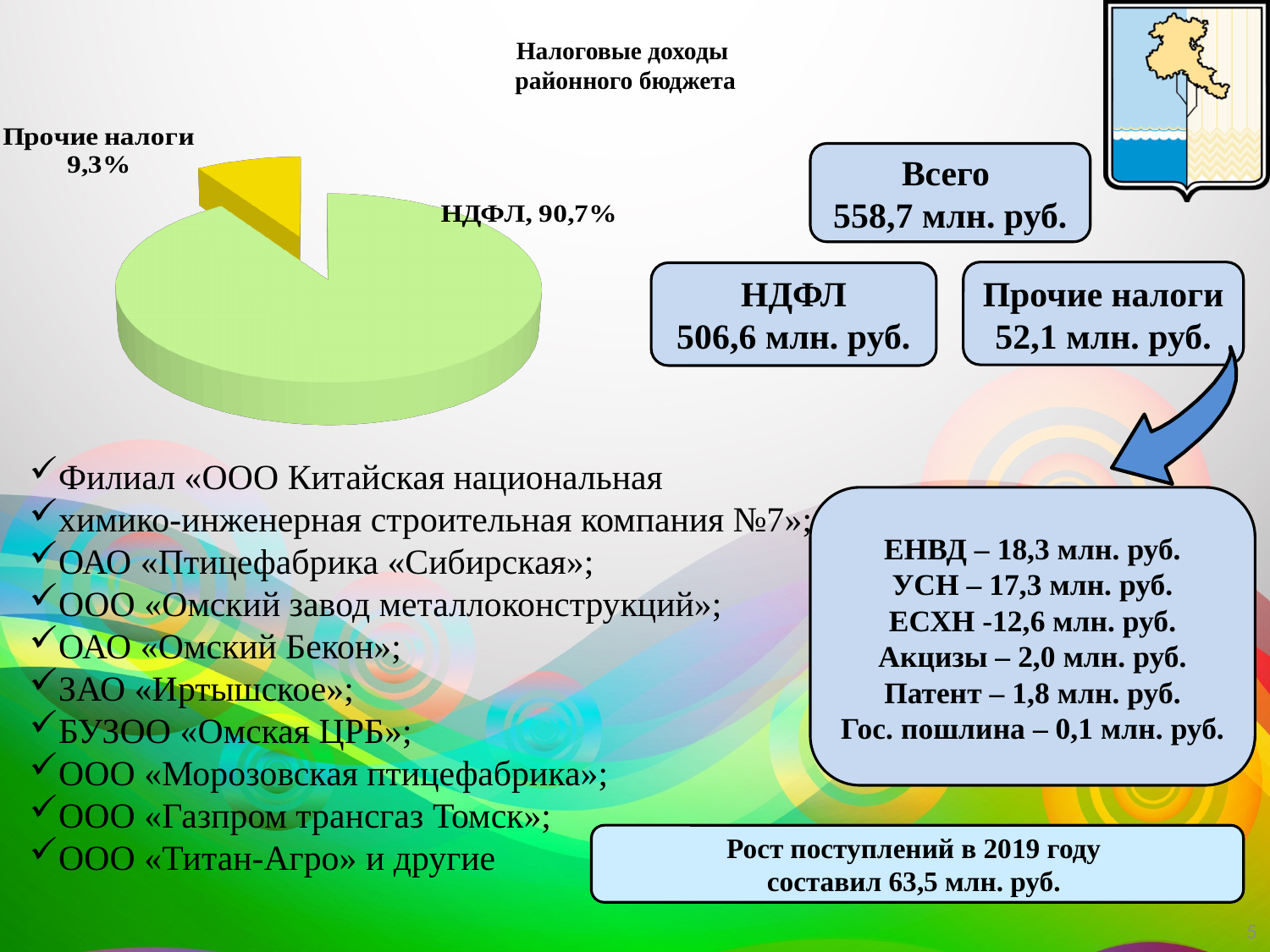
What share of the pie does Прочие налоги account for? 9,3% What kind of chart is shown on the slide? pie chart How many slices does the pie chart have? 2 What share of the pie does НДФЛ account for? 90,7% Which is larger in the pie chart, НДФЛ or Прочие налоги? НДФЛ Which slice of the pie chart is the smallest? Прочие налоги What is the difference in percentage points between the НДФЛ slice and the Прочие налоги slice? 81,4 Which slice of the pie chart is the largest? НДФЛ What colour is the НДФЛ slice of the pie chart? light green What is the title of the chart? Налоговые доходы районного бюджета